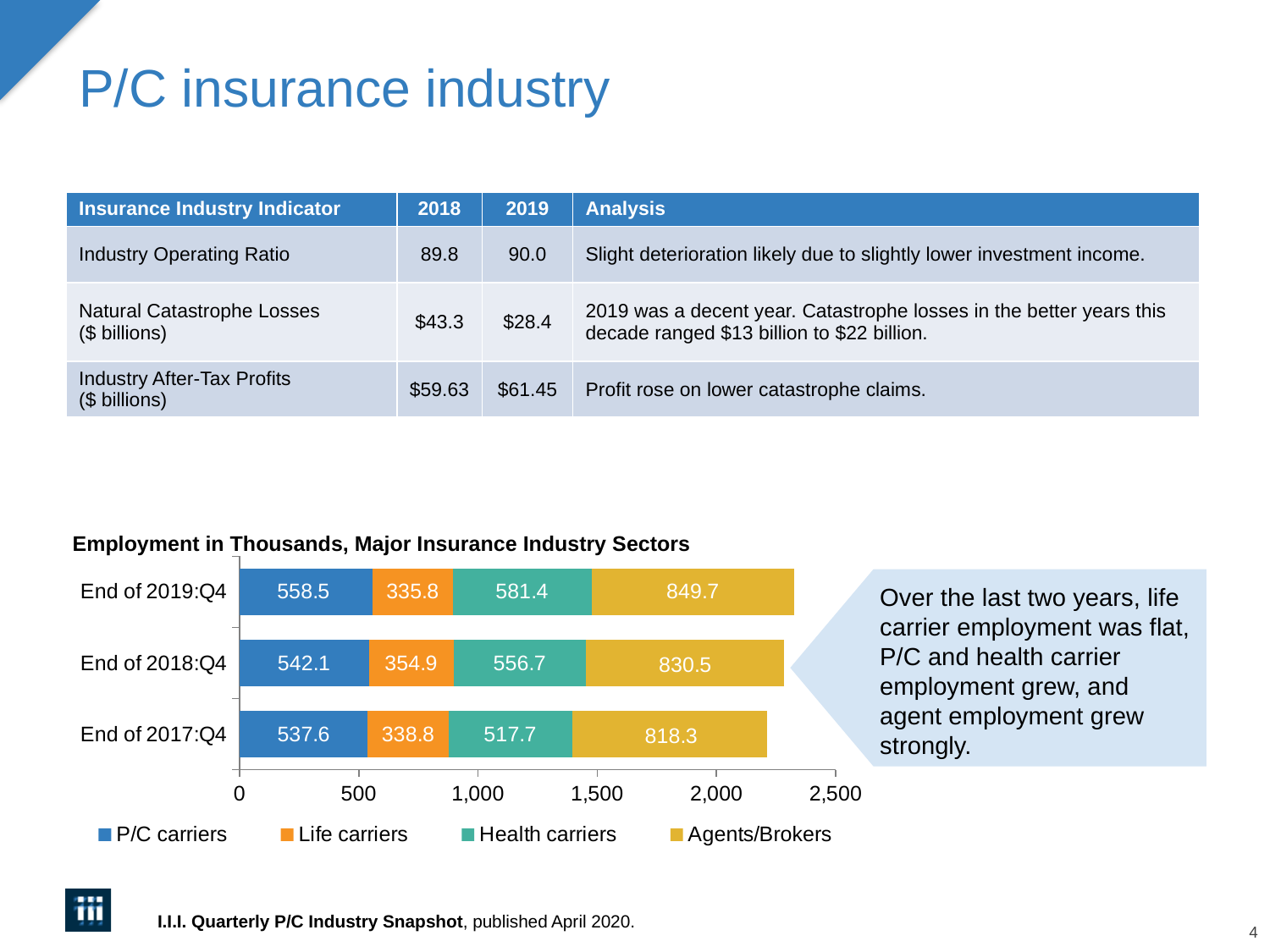
What is the total of the stacked bar for End of 2019:Q4? 2,325.4 What is the value for Life carriers at End of 2018:Q4? 354.9 What is the value for Health carriers at End of 2017:Q4? 517.7 What is the title of the chart? Employment in Thousands, Major Insurance Industry Sectors Which period has the highest value for P/C carriers? End of 2019:Q4 How many series does the chart legend list? 4 What type of chart is shown on the slide? Stacked bar chart Which is larger: Life carriers at End of 2018:Q4 or Life carriers at End of 2019:Q4? End of 2018:Q4 How many categories (time periods) are plotted in the chart? 3 What is the difference between the Health carriers values at End of 2019:Q4 and End of 2017:Q4? 63.7 What is the value for Agents/Brokers at End of 2019:Q4? 849.7 Which period has the lowest value for Agents/Brokers? End of 2017:Q4